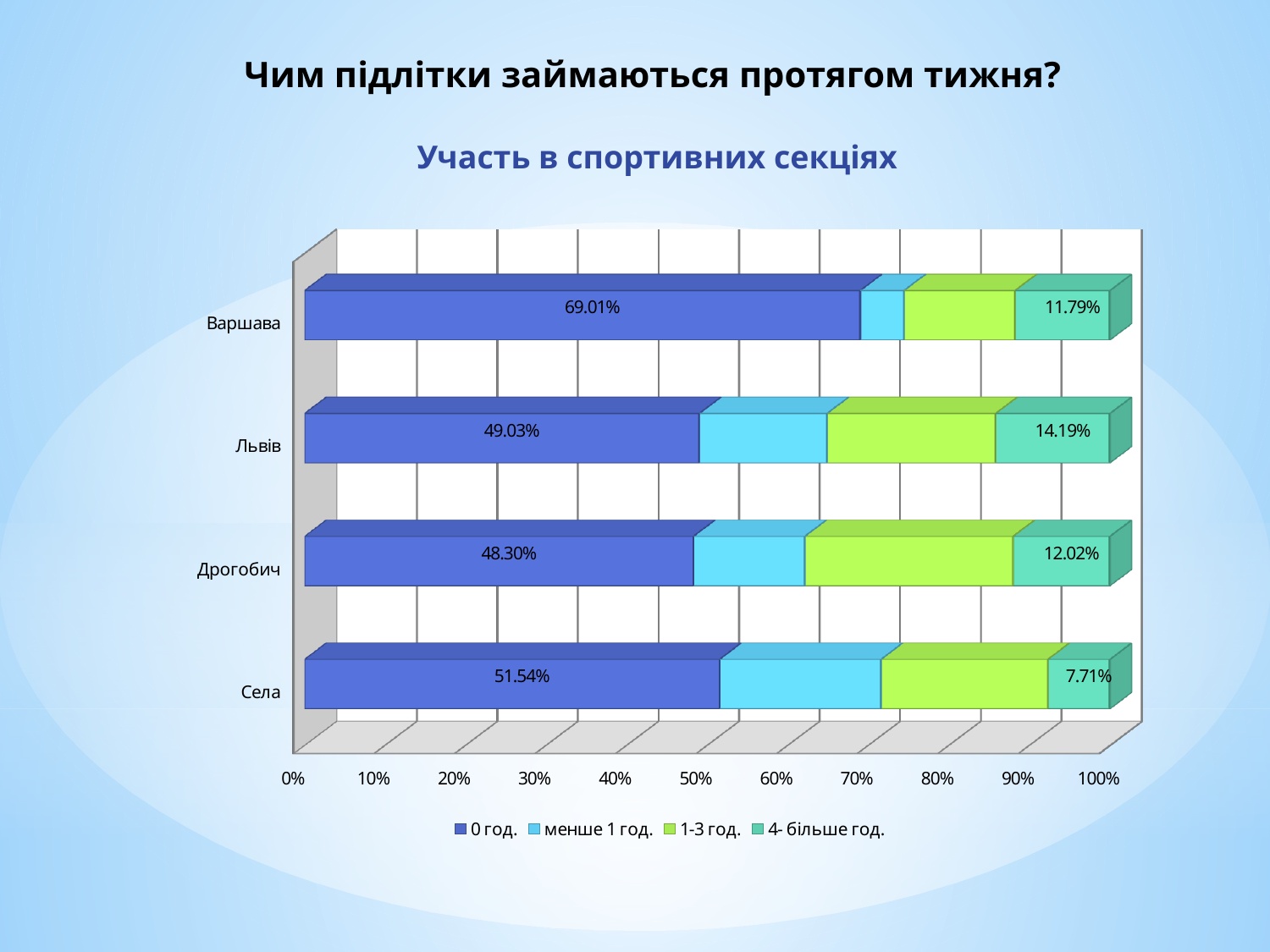
What kind of chart is shown on the slide? Stacked bar chart What is the value for Львів in the 4- більше год. series? 14.19% Which category has the lowest value in the 4- більше год. series? Села What is the value for Села in the 0 год. series? 51.54% What is the difference between the 0 год. values for Варшава and Львів? 19.98% What is the title of the chart? Участь в спортивних секціях Which is larger in the 0 год. series: Львів or Дрогобич? Львів What is the value for Варшава in the 0 год. series? 69.01% How many categories are shown on the chart? 4 Which category has the highest value in the 0 год. series? Варшава How many series does the legend list? 4 What is the value for Дрогобич in the 4- більше год. series? 12.02%